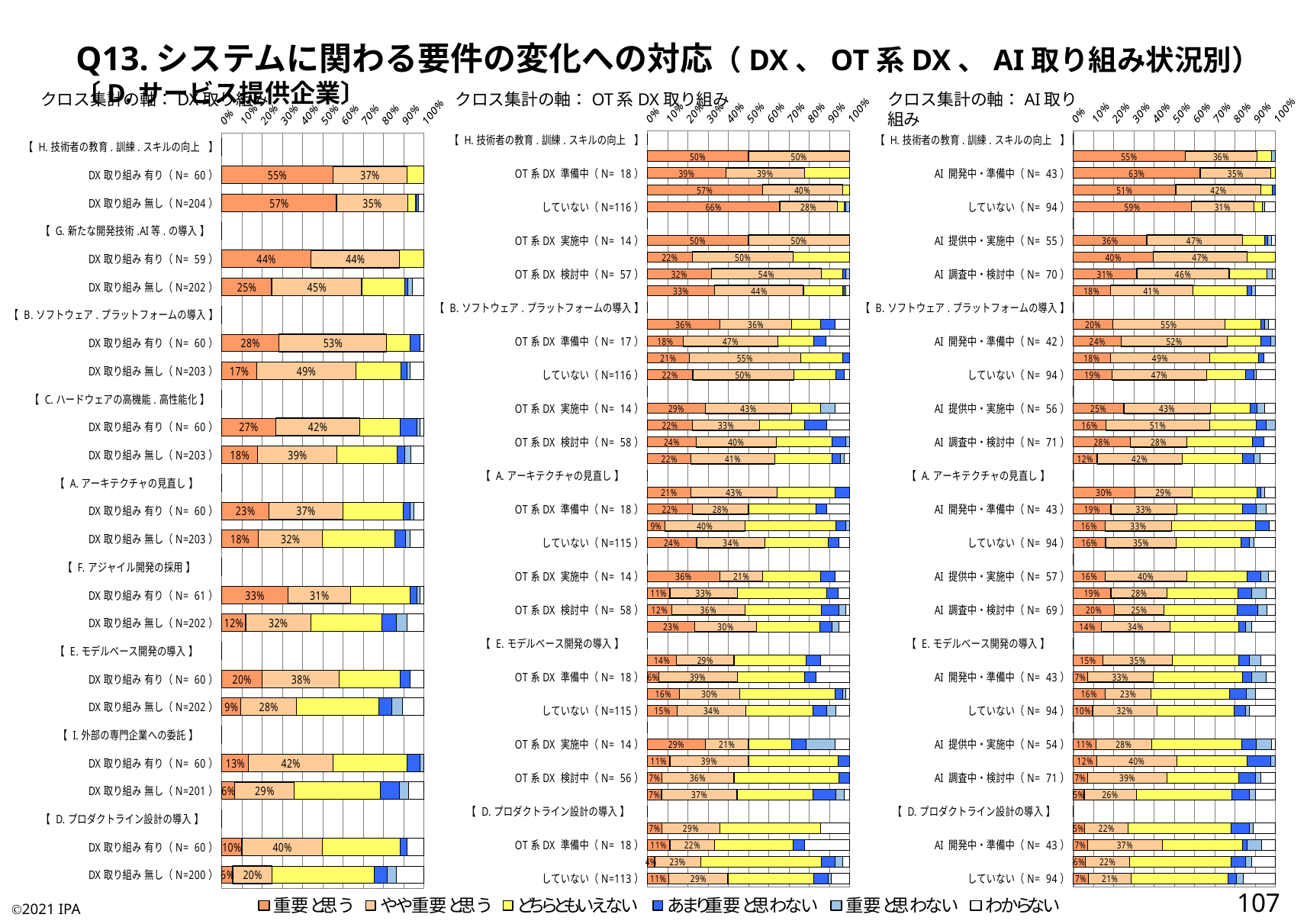
How many response categories does the legend at the bottom of the slide list? 6 In the left chart (クロス集計の軸: DX取り組み), what percentage of DX取り組み有り (N=60) answered やや重要と思う for I. 外部の専門企業への委託? 42% In the left chart (クロス集計の軸: DX取り組み), what percentage of DX取り組み有り (N=59) answered やや重要と思う for G. 新たな開発技術・AI等の導入? 44% What kind of chart is used on this slide? Stacked bar chart In the left chart (クロス集計の軸: DX取り組み), what is the combined share of 重要と思う and やや重要と思う for DX取り組み有り in H. 技術者の教育・訓練・スキルの向上? 92% In the left chart (クロス集計の軸: DX取り組み), what percentage of DX取り組み無し (N=200) answered 重要と思う for D. プロダクトライン設計の導入? 6% In the left chart (クロス集計の軸: DX取り組み), what percentage of DX取り組み有り (N=60) answered 重要と思う for H. 技術者の教育・訓練・スキルの向上? 55% In the left chart (クロス集計の軸: DX取り組み), for H. 技術者の教育・訓練・スキルの向上, how many percentage points higher is the 重要と思う share for DX取り組み無し than for DX取り組み有り? 2 percentage points In the left chart (クロス集計の軸: DX取り組み), what percentage of DX取り組み有り (N=60) answered やや重要と思う for B. ソフトウェア・プラットフォームの導入? 53% In the left chart (クロス集計の軸: DX取り組み), what is the N for DX取り組み無し in H. 技術者の教育・訓練・スキルの向上? 204 In the left chart (クロス集計の軸: DX取り組み), what percentage of DX取り組み無し (N=204) answered 重要と思う for H. 技術者の教育・訓練・スキルの向上? 57% In the left chart (クロス集計の軸: DX取り組み), for G. 新たな開発技術・AI等の導入, which group has the larger 重要と思う share: DX取り組み有り or DX取り組み無し? DX取り組み有り